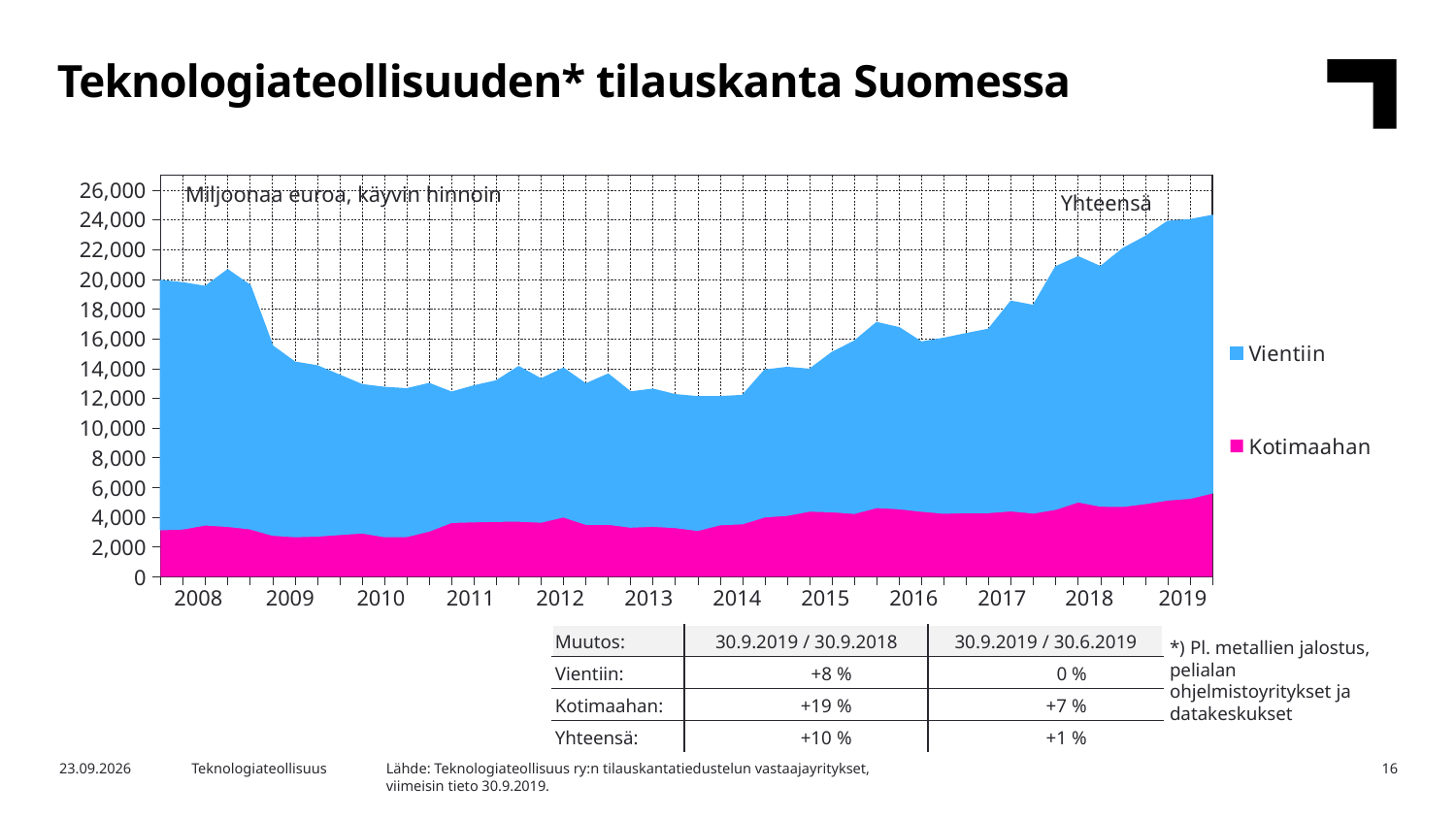
Does the total (Yhteensä) order book rise or fall from 2016 to 2019? rise Is the total (Yhteensä) order book in 2013 greater or less than 14,000? less Is the total (Yhteensä) order book at the end of 2019 greater or less than 22,000? greater What unit is stated in the label inside the chart area? Miljoonaa euroa, käyvin hinnoin Is the total (Yhteensä) order book at the start of 2008 greater or less than 18,000? greater How many year labels are shown on the x axis? 12 What are the two series named in the chart legend? Vientiin and Kotimaahan How many series does the chart legend list? 2 In which year does the total (Yhteensä) order book reach its highest level? 2019 What kind of chart is shown on the slide? Stacked area chart